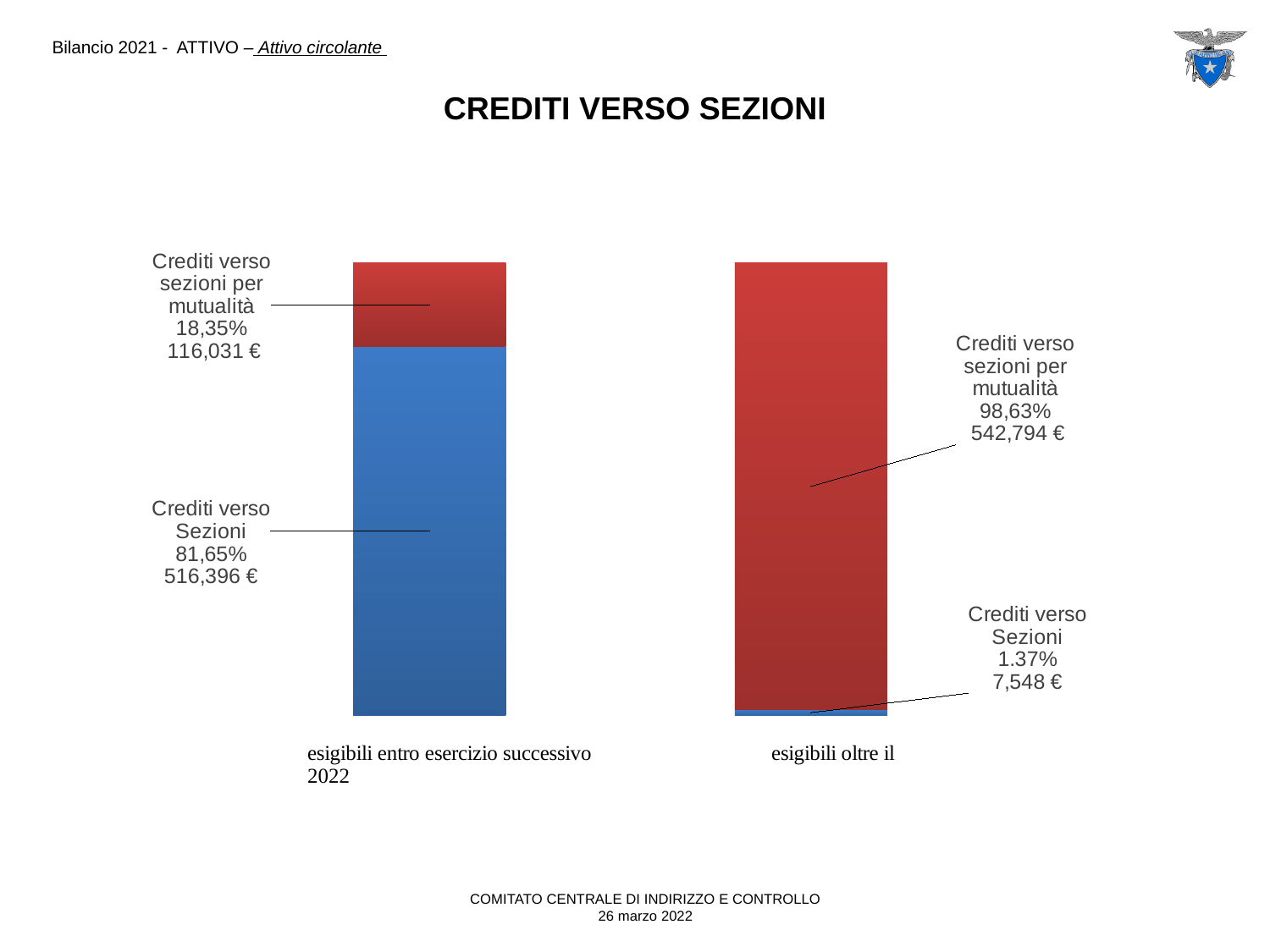
What is the value of Crediti verso Sezioni in the 'esigibili entro esercizio successivo 2022' bar? 516,396 € What is the title of the chart? CREDITI VERSO SEZIONI What percentage share does Crediti verso Sezioni have in the 'esigibili entro esercizio successivo 2022' bar? 81,65% What is the value of Crediti verso sezioni per mutualità in the 'esigibili oltre il' bar? 542,794 € In the 'esigibili entro esercizio successivo 2022' bar, which is larger: Crediti verso Sezioni or Crediti verso sezioni per mutualità? Crediti verso Sezioni What is the value of Crediti verso sezioni per mutualità in the 'esigibili entro esercizio successivo 2022' bar? 116,031 € What is the difference between Crediti verso Sezioni and Crediti verso sezioni per mutualità in the 'esigibili entro esercizio successivo 2022' bar? 400,365 € How many bars (categories) are shown in the chart? 2 What kind of chart is shown on the slide? Stacked bar chart What is the total of the 'esigibili oltre il' bar? 550,342 € What percentage share does Crediti verso sezioni per mutualità have in the 'esigibili oltre il' bar? 98,63% What is the value of Crediti verso Sezioni in the 'esigibili oltre il' bar? 7,548 €